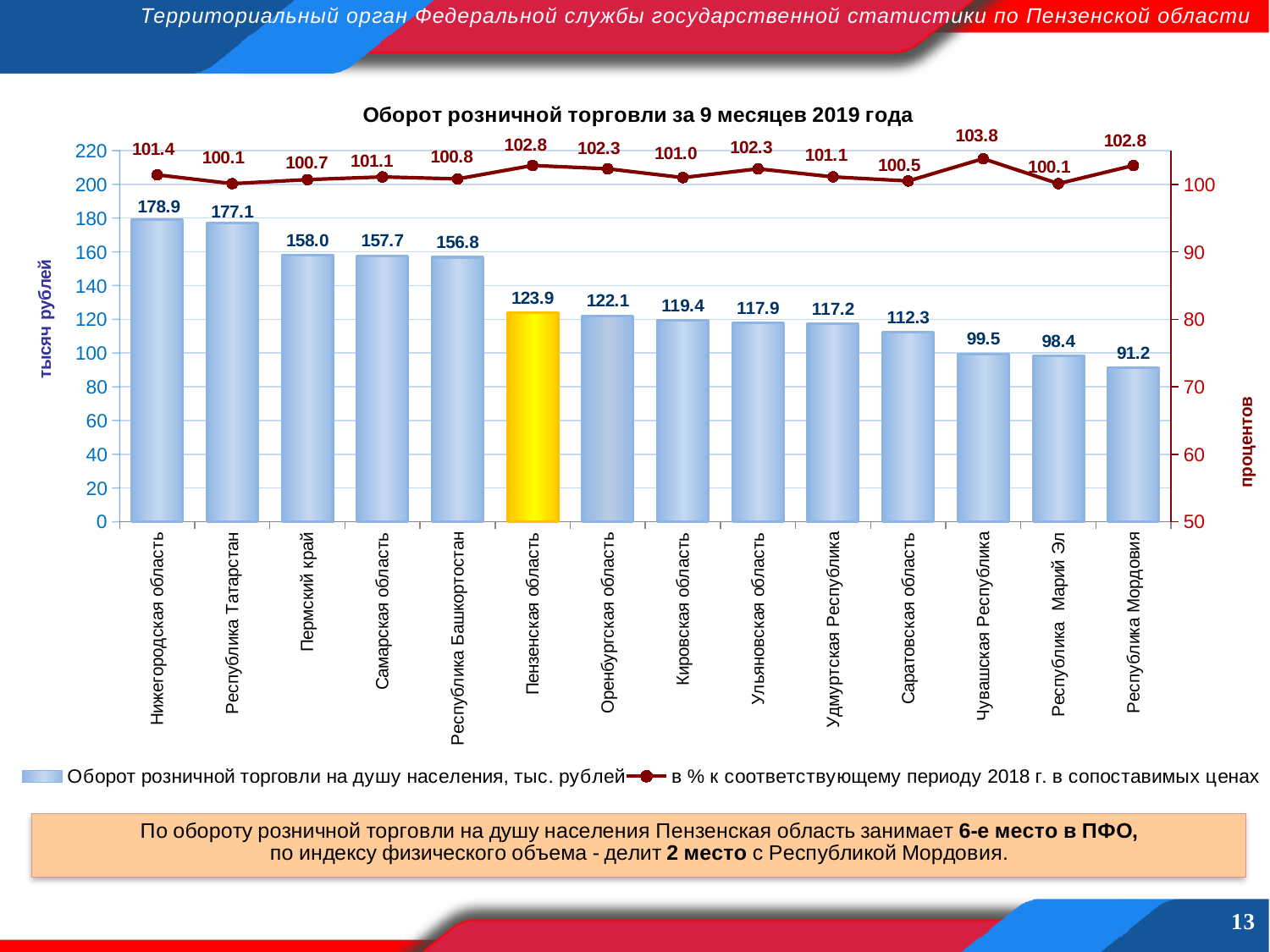
What is the retail turnover per capita (thousand rubles) for Пензенская область? 123.9 What is the value of the line series (% to the corresponding period of 2018) for Чувашская Республика? 103.8 What is the difference in retail turnover per capita between Нижегородская область and Республика Татарстан? 1.8 Which region has the highest retail turnover per capita bar? Нижегородская область Which region has the highest value on the line series (% to 2018)? Чувашская Республика How many series does the legend list? 2 How many regions are shown on the x axis of the chart? 14 Which has a higher line value (% to 2018): Оренбургская область or Кировская область? Оренбургская область Which region has the lowest retail turnover per capita bar? Республика Мордовия Which has a larger retail turnover per capita: Пермский край or Самарская область? Пермский край What is the difference in retail turnover per capita between Пензенская область and Республика Мордовия? 32.7 What is the title of the chart? Оборот розничной торговли за 9 месяцев 2019 года